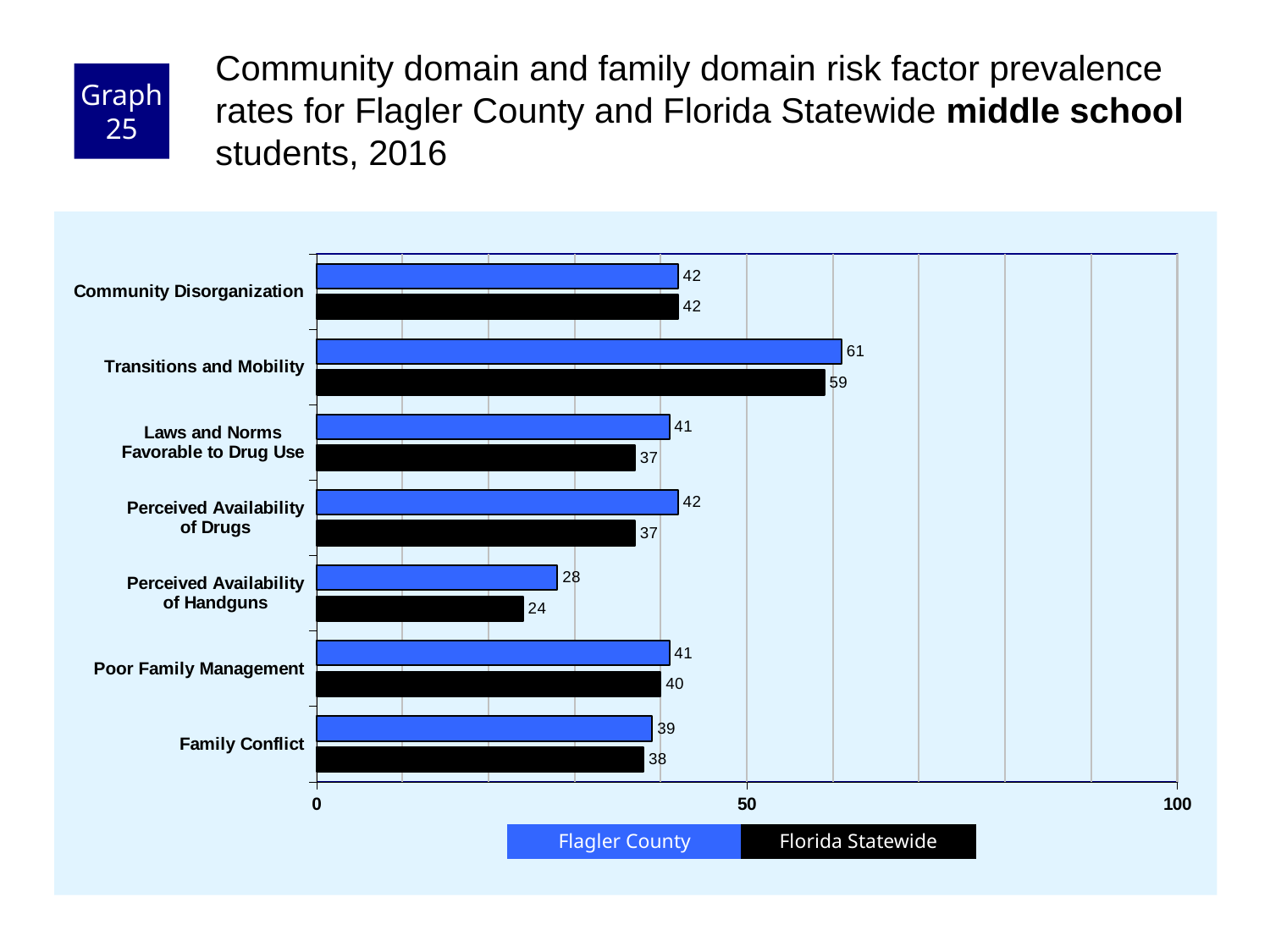
What is the Florida Statewide value for Perceived Availability of Handguns? 24 Is the Florida Statewide value for Transitions and Mobility greater or less than 50? greater What is the Florida Statewide value for Laws and Norms Favorable to Drug Use? 37 Which risk factor has the highest Flagler County value? Transitions and Mobility How many risk factor categories are shown on the chart? 7 Which colour represents Florida Statewide in the chart? black What is the difference between the Flagler County and Florida Statewide values for Perceived Availability of Drugs? 5 Which is larger for Perceived Availability of Handguns: the Flagler County value or the Florida Statewide value? Flagler County How many series does the legend list? 2 What kind of chart is shown on the slide? bar chart Which risk factor has the lowest Florida Statewide value? Perceived Availability of Handguns What is the Flagler County value for Transitions and Mobility? 61